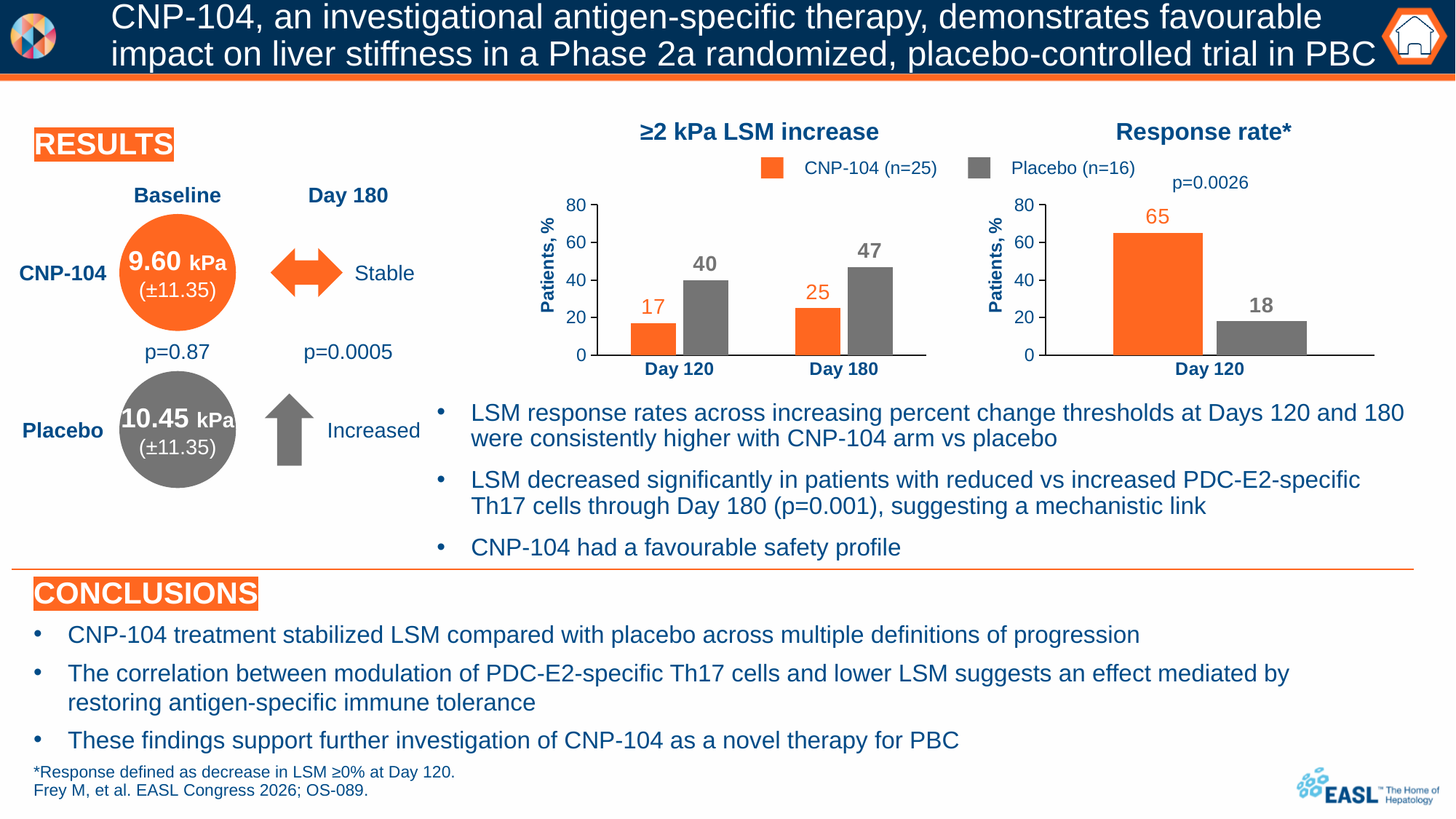
What kind of chart is the 'Response rate*' chart? Bar chart In the '≥2 kPa LSM increase' chart, what is the value for CNP-104 at Day 120? 17 In the '≥2 kPa LSM increase' chart, which bar has the highest value? Placebo at Day 180 In the '≥2 kPa LSM increase' chart, which series has the higher value at Day 180, CNP-104 or Placebo? Placebo In the '≥2 kPa LSM increase' chart, does the CNP-104 value rise or fall from Day 120 to Day 180? Rise In the 'Response rate*' chart, what is the value for CNP-104 at Day 120? 65 In the '≥2 kPa LSM increase' chart, which bar has the lowest value? CNP-104 at Day 120 How many series does the legend list for the bar charts? 2 In the '≥2 kPa LSM increase' chart, what is the difference between Placebo and CNP-104 at Day 120? 23 In the '≥2 kPa LSM increase' chart, what is the value for Placebo at Day 180? 47 In the 'Response rate*' chart, what is the difference between CNP-104 and Placebo? 47 In the 'Response rate*' chart, what is the value for Placebo at Day 120? 18